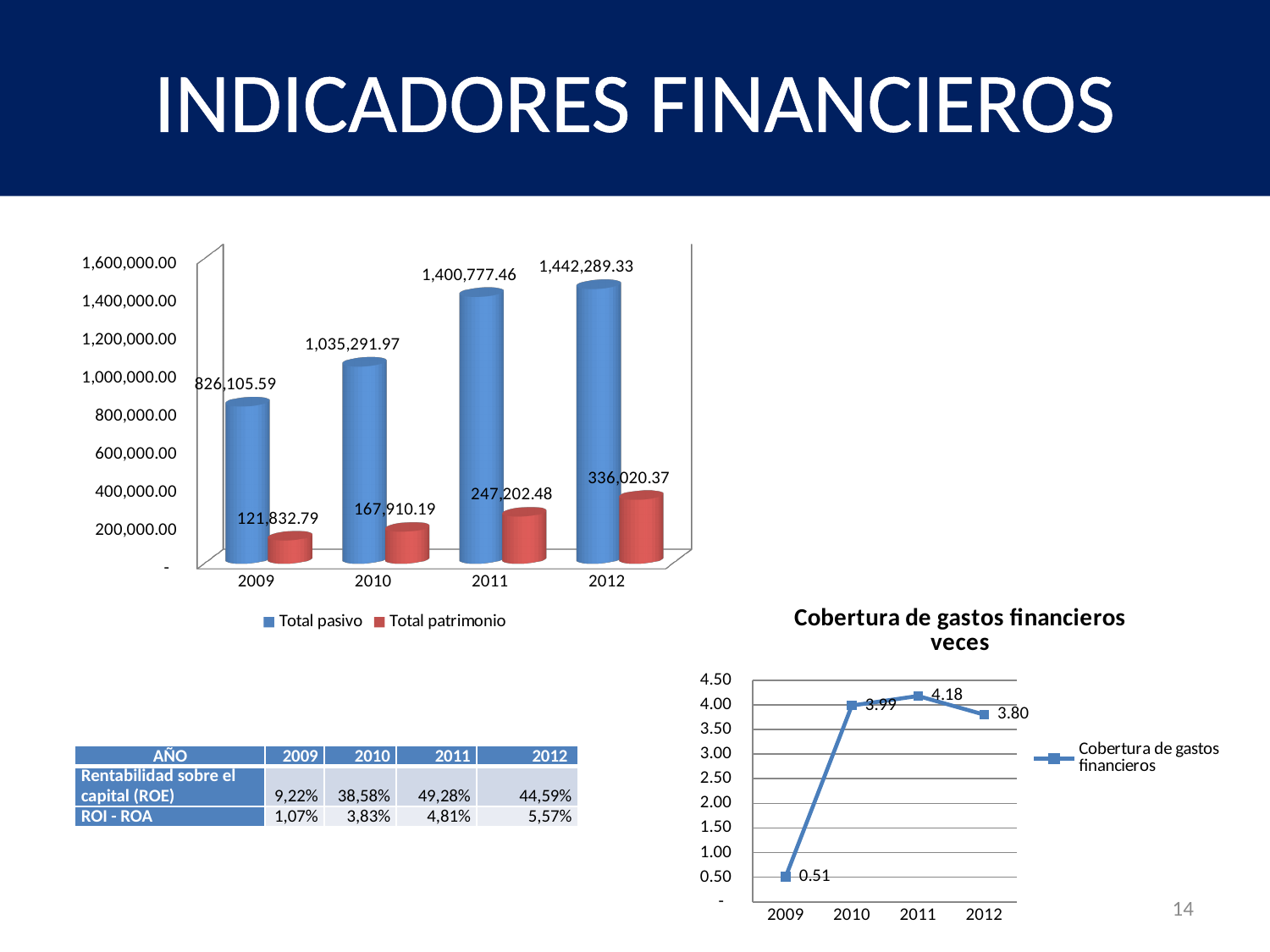
In the bar chart on the left, what is the value of Total patrimonio for 2009? 121,832.79 In the bar chart on the left, which year has the lowest Total patrimonio? 2009 In the bar chart on the left, does Total pasivo rise or fall from 2009 to 2012? rise In the chart titled 'Cobertura de gastos financieros veces', which year has the highest value? 2011 In the bar chart on the left, which year has the highest Total pasivo? 2012 In the bar chart on the left, how many series does the legend list? 2 In the bar chart on the left, is Total patrimonio for 2012 greater or less than 400,000.00? less What kind of chart is 'Cobertura de gastos financieros veces'? line chart In the chart titled 'Cobertura de gastos financieros veces', what is the value for 2010? 3.99 In the bar chart on the left, what is the value of Total pasivo for 2011? 1,400,777.46 In the chart titled 'Cobertura de gastos financieros veces', what is the difference between the 2011 and 2012 values? 0.38 In the bar chart on the left, what is the difference between Total pasivo and Total patrimonio in 2012? 1,106,268.96